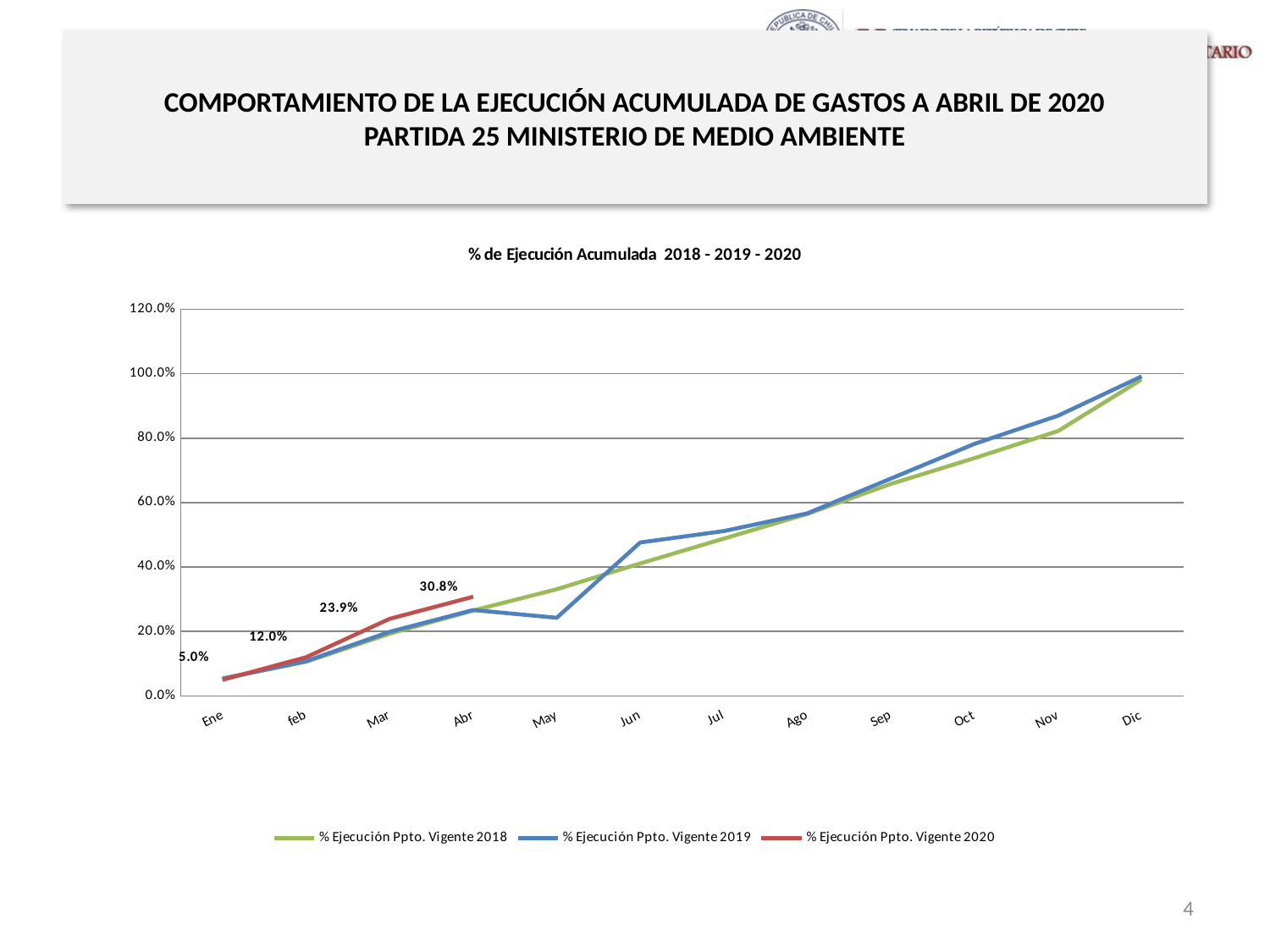
What is the difference between the 2020 values for Abr and Mar? 6.9 percentage points What is the value of % Ejecución Ppto. Vigente 2020 in Mar? 23.9% How many series does the legend list? 3 What is the title of the chart? % de Ejecución Acumulada 2018 - 2019 - 2020 What is the value of % Ejecución Ppto. Vigente 2020 in Abr? 30.8% How many months are shown on the x axis? 12 What is the value of % Ejecución Ppto. Vigente 2020 in Ene? 5.0% What is the difference between the 2020 values for Mar and feb? 11.9 percentage points What kind of chart is shown on the slide? Line chart Is the value for % Ejecución Ppto. Vigente 2019 in Jun greater or less than 40.0%? greater In May, which series is larger: % Ejecución Ppto. Vigente 2018 or % Ejecución Ppto. Vigente 2019? % Ejecución Ppto. Vigente 2018 Does the % Ejecución Ppto. Vigente 2020 line rise or fall from Ene to Abr? Rises